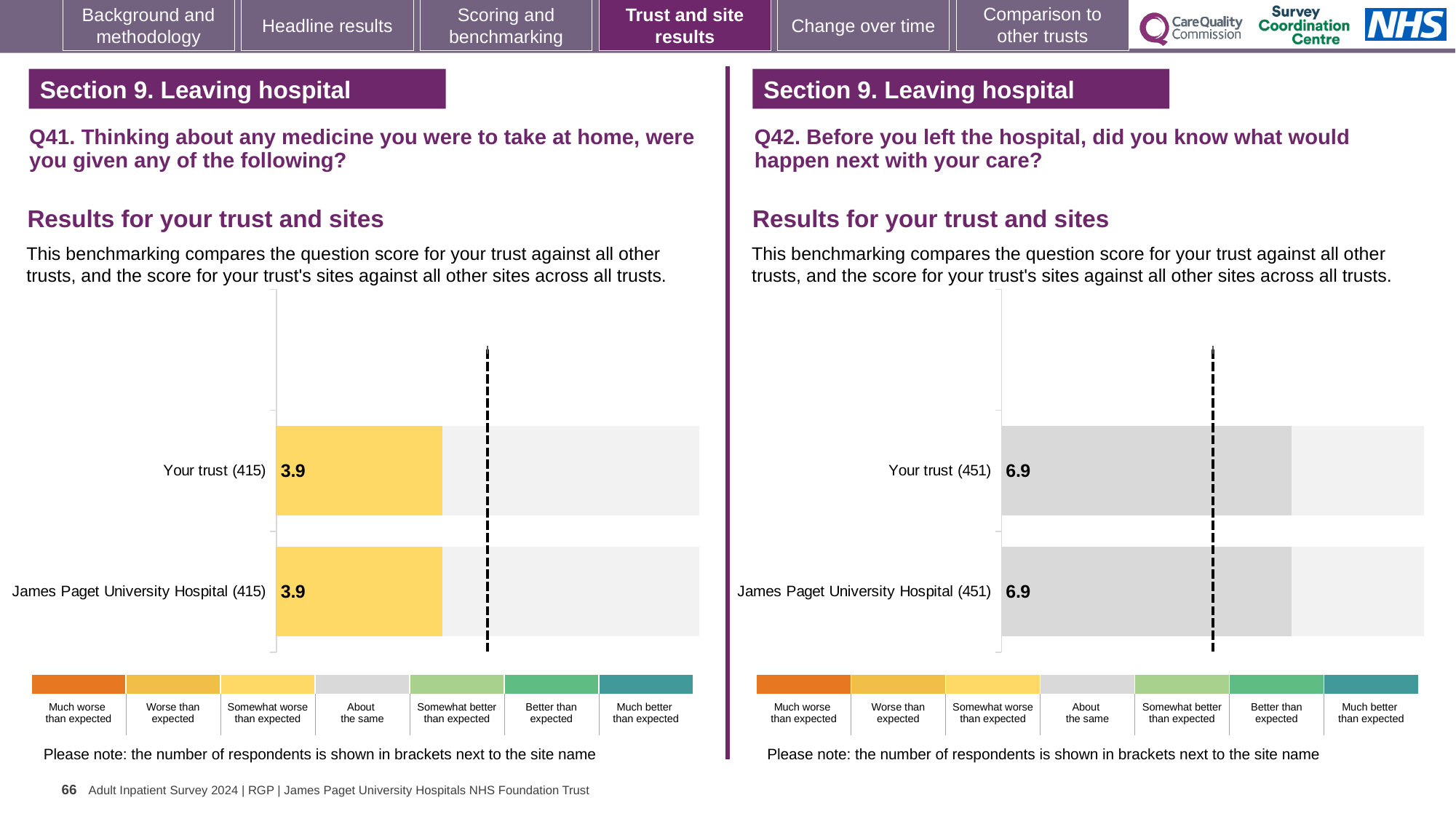
On the Q42 chart (right), what is the difference between the score for Your trust and the score for James Paget University Hospital? 0.0 On the Q41 chart (left), which benchmark category does the colour of the bars correspond to according to the legend? Somewhat worse than expected On the Q41 chart (left), what is the score for James Paget University Hospital (415)? 3.9 On the Q42 chart (right), which benchmark category does the colour of the bars correspond to according to the legend? About the same On the Q42 chart (right), what is the score for James Paget University Hospital (451)? 6.9 What kind of chart is used for the Q41 results on the left? Bar chart How many bars are plotted on the Q42 chart (right)? 2 How many bars are plotted on the Q41 chart (left)? 2 How many respondents are shown in brackets for Your trust on the Q42 chart (right)? 451 On the Q42 chart (right), what is the score for Your trust (451)? 6.9 On the Q41 chart (left), what is the score for Your trust (415)? 3.9 On the Q41 chart (left), what is the difference between the score for Your trust and the score for James Paget University Hospital? 0.0